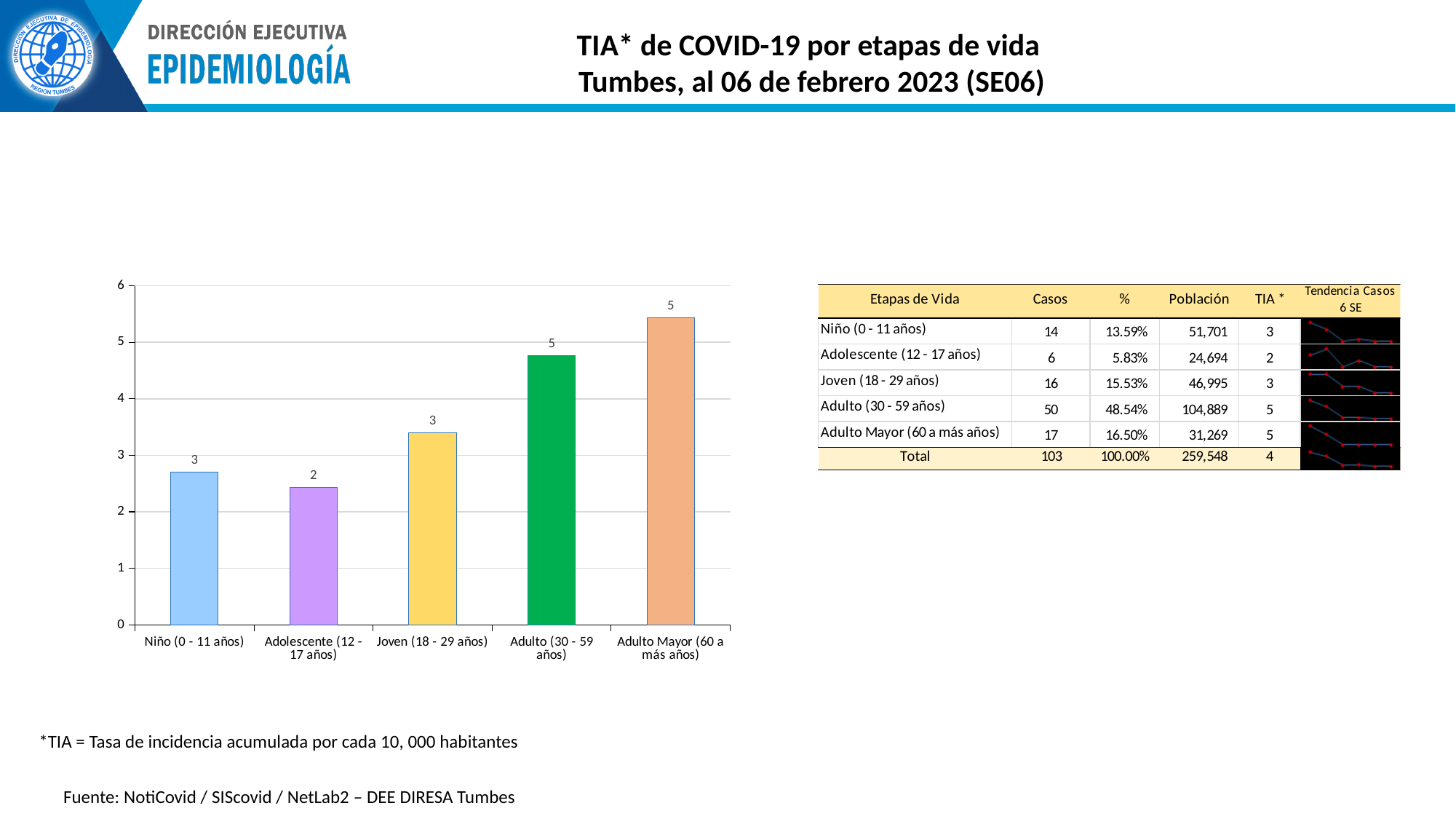
Using the data labels, what is the difference between the value for Adulto Mayor (60 a más años) and the value for Adolescente (12 - 17 años)? 3 Which age group has the tallest bar in the chart? Adulto Mayor (60 a más años) What is the data label on the bar for Joven (18 - 29 años)? 3 Which age group has the shortest bar in the chart? Adolescente (12 - 17 años) How many age-group categories are shown on the x axis of the chart? 5 What kind of chart is shown on the slide? bar chart Which bar is taller: Adulto (30 - 59 años) or Adulto Mayor (60 a más años)? Adulto Mayor (60 a más años) What is the data label on the bar for Adulto (30 - 59 años)? 5 Is the value for Adolescente (12 - 17 años) greater or less than 3? less What colour is the bar for Adulto (30 - 59 años)? green What is the data label on the bar for Adolescente (12 - 17 años)? 2 Is the value for Adulto (30 - 59 años) greater or less than 4? greater